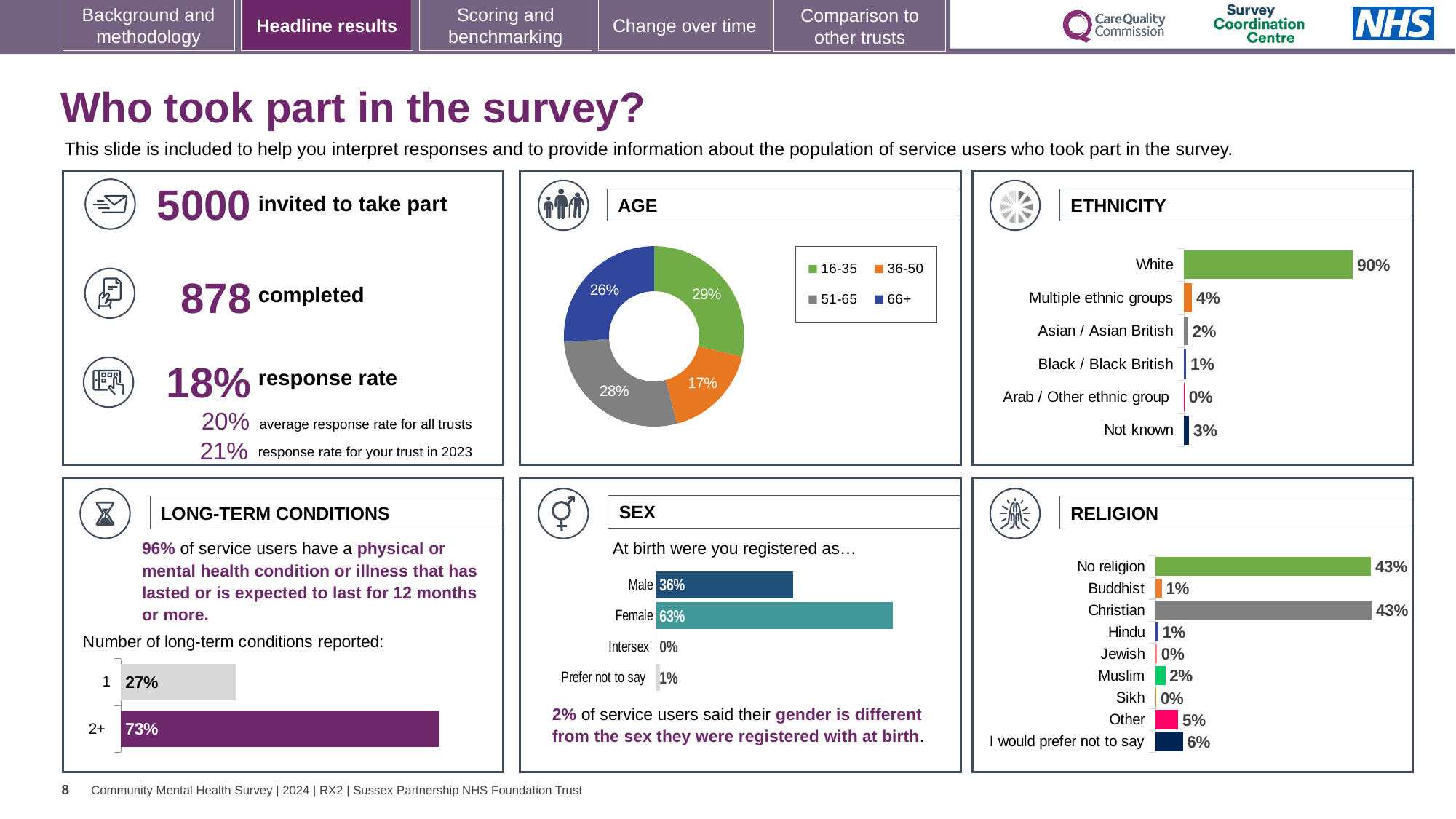
In the LONG-TERM CONDITIONS chart, what percentage reported 2+ long-term conditions? 73% In the ETHNICITY chart, what is the difference between White and Not known? 87% How many age groups does the legend of the AGE chart list? 4 What kind of chart is the AGE chart? Donut chart In the AGE chart, what percentage of respondents were aged 51-65? 28% In the SEX chart, which is larger, Male or Female? Female In the RELIGION chart, what is the value for Other? 5% How many categories are shown in the RELIGION chart? 9 In the AGE chart, which age group has the largest share? 16-35 How many categories are shown in the ETHNICITY chart? 6 In the ETHNICITY chart, what is the value for Multiple ethnic groups? 4% In the AGE chart, which age group has the smallest share? 36-50